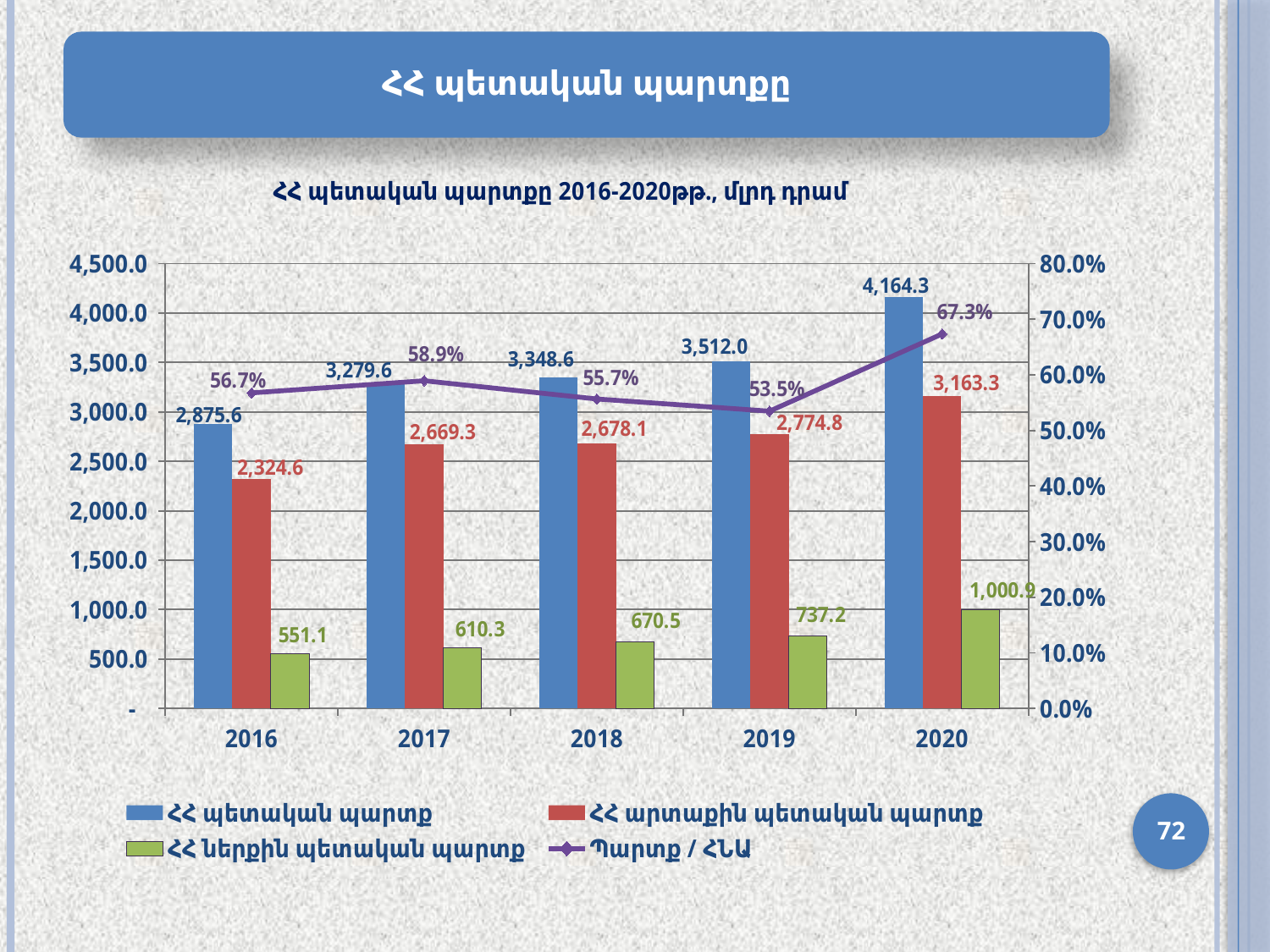
What is the value of the red series (ՀՀ արտաքին պետական պարտք) for 2017? 2,669.3 In which year is the line series (Պարտք / ՀՆԱ) at its lowest? 2019 What is the difference between the blue series (ՀՀ պետական պարտք) values for 2020 and 2019? 652.3 What is the value of the blue series (ՀՀ պետական պարտք) for 2020? 4,164.3 What is the value of the green series (ՀՀ ներքին պետական պարտք) for 2019? 737.2 What is the value of the line series (Պարտք / ՀՆԱ) for 2018? 55.7% In which year is the green series (ՀՀ ներքին պետական պարտք) at its highest? 2020 Does the blue series (ՀՀ պետական պարտք) rise or fall from 2016 to 2020? Rise What kind of chart is this? Combined bar and line chart How many series does the legend list? 4 How many years are shown on the x axis? 5 Which is larger: the red series (ՀՀ արտաքին պետական պարտք) value for 2018 or for 2017? 2018